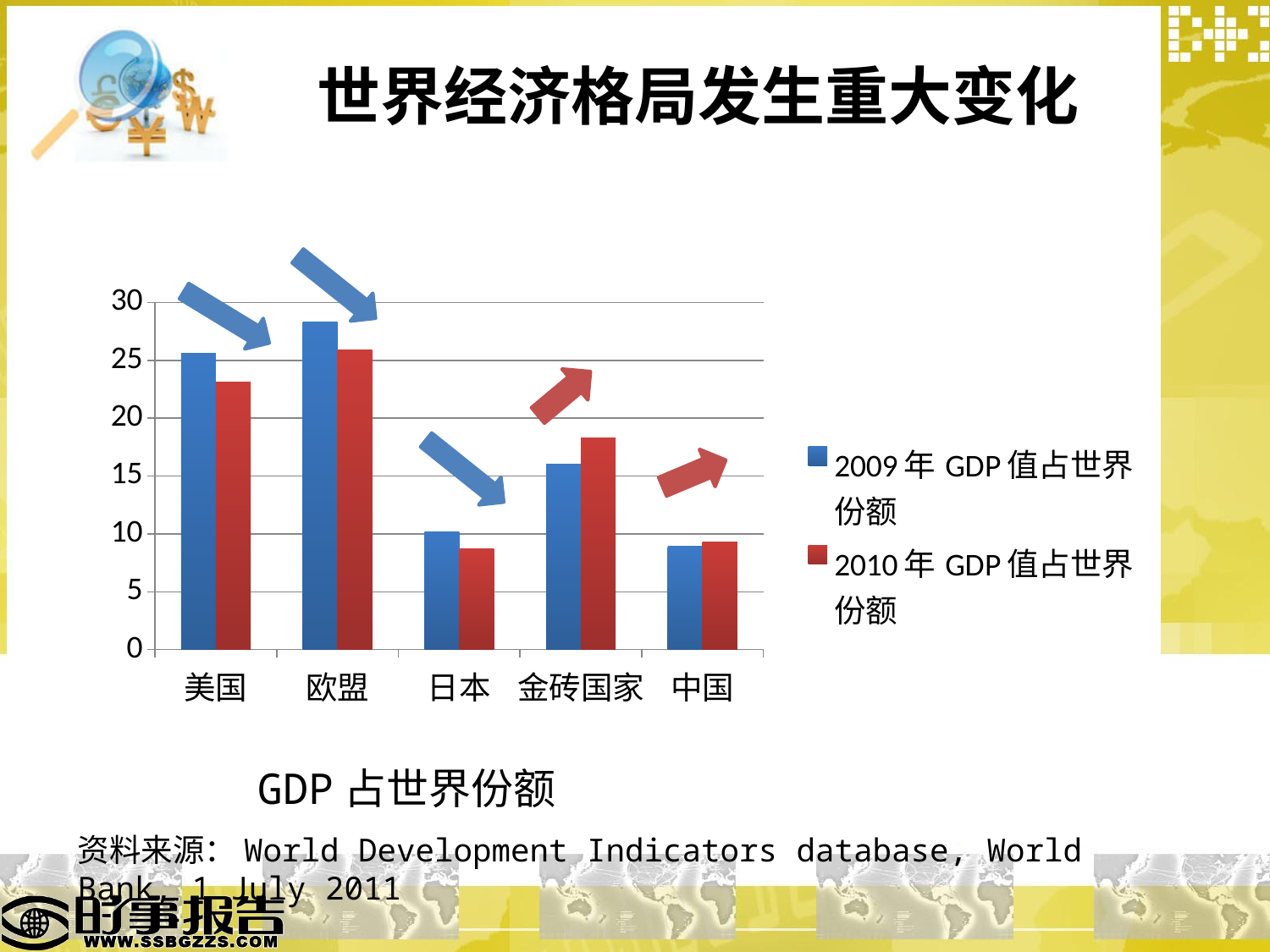
What kind of chart is shown on the slide? bar chart How many series does the chart's legend list? 2 Is the 2009年GDP值占世界份额 value for 欧盟 greater or less than 25? greater Which category has the highest value for the 2010年GDP值占世界份额 series? 欧盟 Which category has the lowest value for the 2009年GDP值占世界份额 series? 中国 For 金砖国家, which is larger: the 2009年GDP值占世界份额 value or the 2010年GDP值占世界份额 value? 2010年GDP值占世界份额 What is the caption/title given below the chart? GDP 占世界份额 Is the 2010年GDP值占世界份额 value for 金砖国家 greater or less than 15? greater How many categories are shown on the x axis of the chart? 5 For 美国, which is larger: the 2009年GDP值占世界份额 value or the 2010年GDP值占世界份额 value? 2009年GDP值占世界份额 Is the 2010年GDP值占世界份额 value for 日本 greater or less than 10? less Which category has the highest value for the 2009年GDP值占世界份额 series? 欧盟